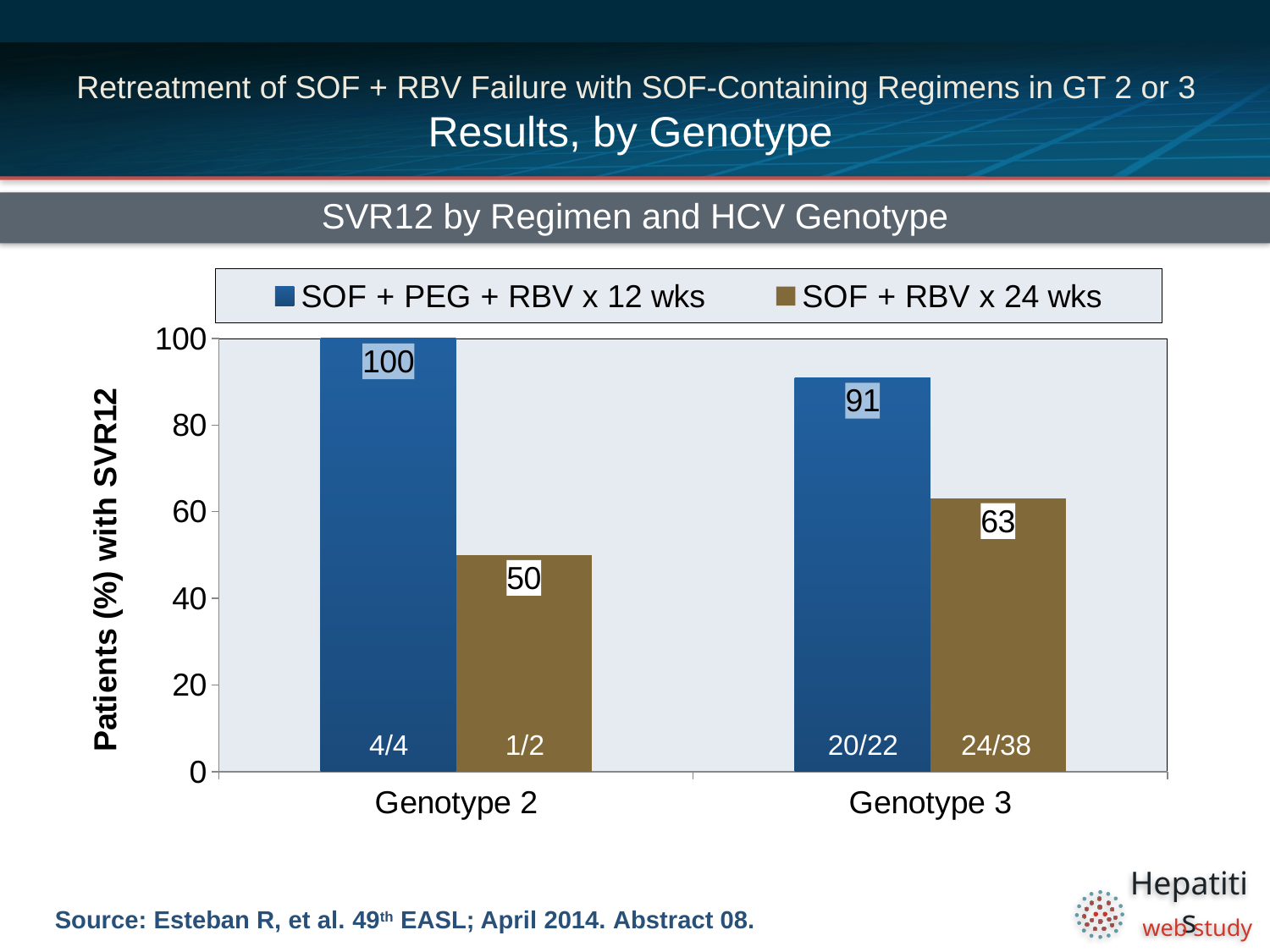
How many genotype categories are shown on the x axis? 2 What is the difference between the SOF + PEG + RBV x 12 wks and SOF + RBV x 24 wks values in Genotype 3? 28 Which is larger in Genotype 2: SOF + PEG + RBV x 12 wks or SOF + RBV x 24 wks? SOF + PEG + RBV x 12 wks What is the SVR12 value for SOF + RBV x 24 wks in Genotype 3? 63 What patient fraction is shown for SOF + RBV x 24 wks in Genotype 3? 24/38 How many series does the legend list? 2 Which bar has the lowest SVR12 value on the chart? SOF + RBV x 24 wks, Genotype 2 What is the SVR12 value for SOF + PEG + RBV x 12 wks in Genotype 3? 91 What kind of chart is shown on the slide? Bar chart What is the label of the y axis? Patients (%) with SVR12 What is the SVR12 value for SOF + RBV x 24 wks in Genotype 2? 50 What is the SVR12 value for SOF + PEG + RBV x 12 wks in Genotype 2? 100